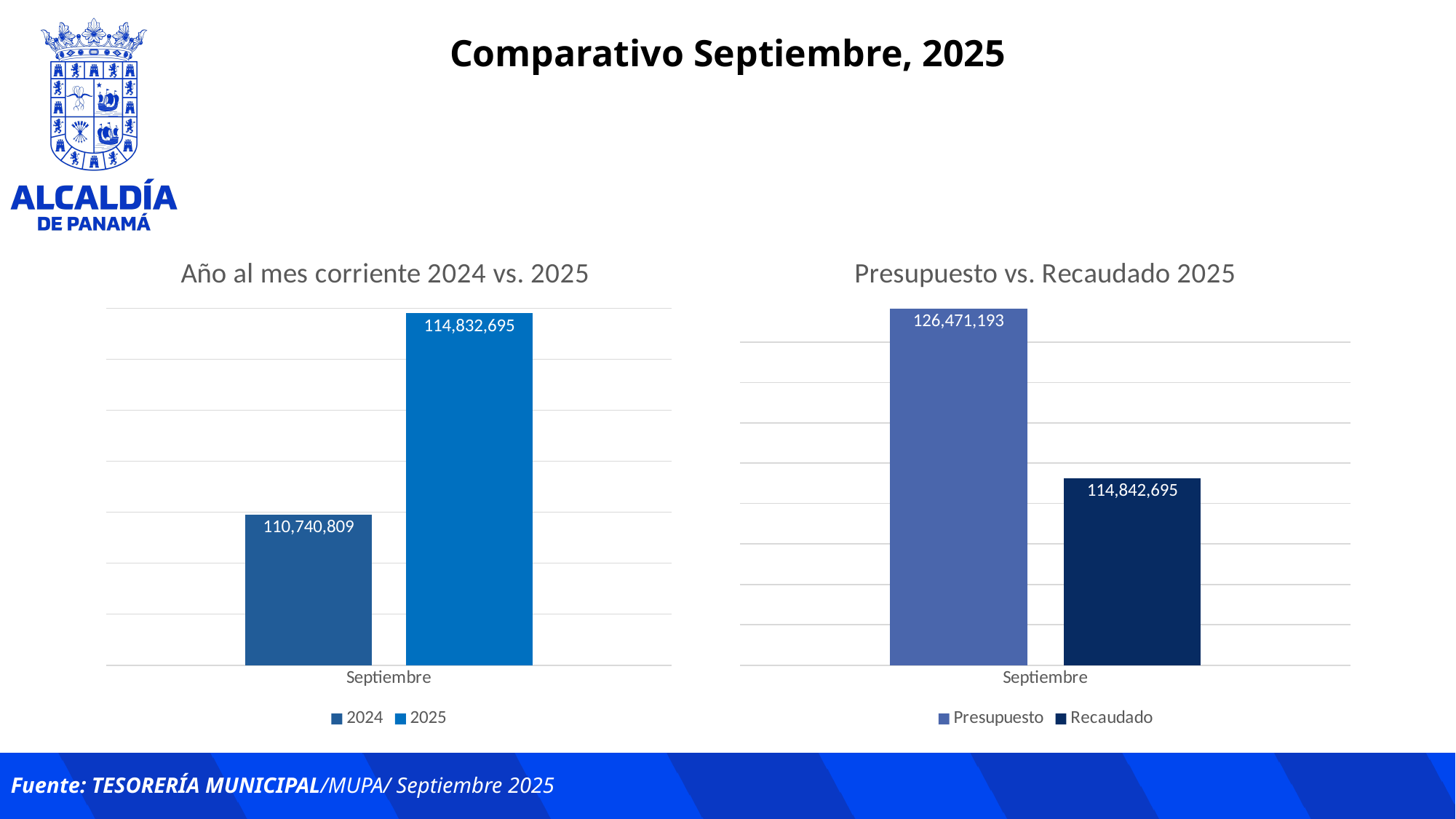
In the 'Presupuesto vs. Recaudado 2025' chart, is Presupuesto larger or smaller than Recaudado? larger In the 'Año al mes corriente 2024 vs. 2025' chart, which series has the higher value? 2025 In the 'Año al mes corriente 2024 vs. 2025' chart, what is the difference between the 2025 and 2024 values? 4,091,886 In the 'Presupuesto vs. Recaudado 2025' chart, how much larger is Presupuesto than Recaudado? 11,628,498 In the 'Año al mes corriente 2024 vs. 2025' chart, what is the value for 2024? 110,740,809 What category label appears on the x axis of the 'Año al mes corriente 2024 vs. 2025' chart? Septiembre In the 'Presupuesto vs. Recaudado 2025' chart, what is the value for Recaudado? 114,842,695 In the 'Presupuesto vs. Recaudado 2025' chart, what is the value for Presupuesto? 126,471,193 How many series does the legend of the 'Año al mes corriente 2024 vs. 2025' chart list? 2 In the 'Año al mes corriente 2024 vs. 2025' chart, what is the value for 2025? 114,832,695 In the 'Presupuesto vs. Recaudado 2025' chart, which series has the lower value? Recaudado What kind of chart is the 'Presupuesto vs. Recaudado 2025' chart? bar chart